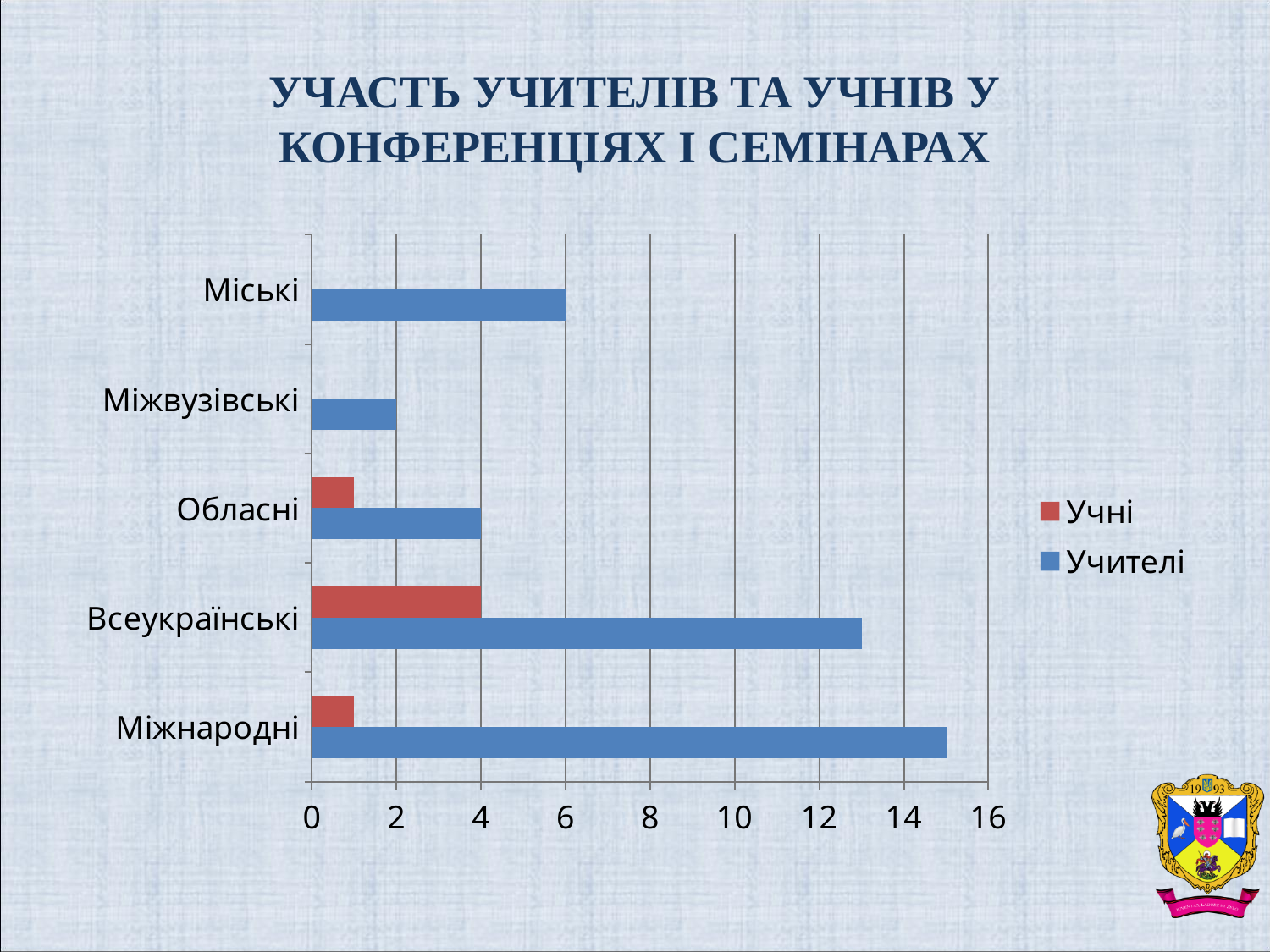
What is the value for Учителі in the Міські category? 6 What is the value for Учителі in the Обласні category? 4 Which category has the highest value for Учителі? Міжнародні How many series does the legend list? 2 Which is larger: the Учителі value for Всеукраїнські or the Учителі value for Міські? Всеукраїнські Which category has the lowest value for Учителі? Міжвузівські What kind of chart is shown on the slide? bar chart What is the value for Учні in the Всеукраїнські category? 4 What is the value for Учителі in the Міжвузівські category? 2 Is the value for Учителі in the Міжнародні category greater or less than 14? greater What is the difference between the Учителі values for Міські and Міжвузівські? 4 How many categories are shown on the chart? 5